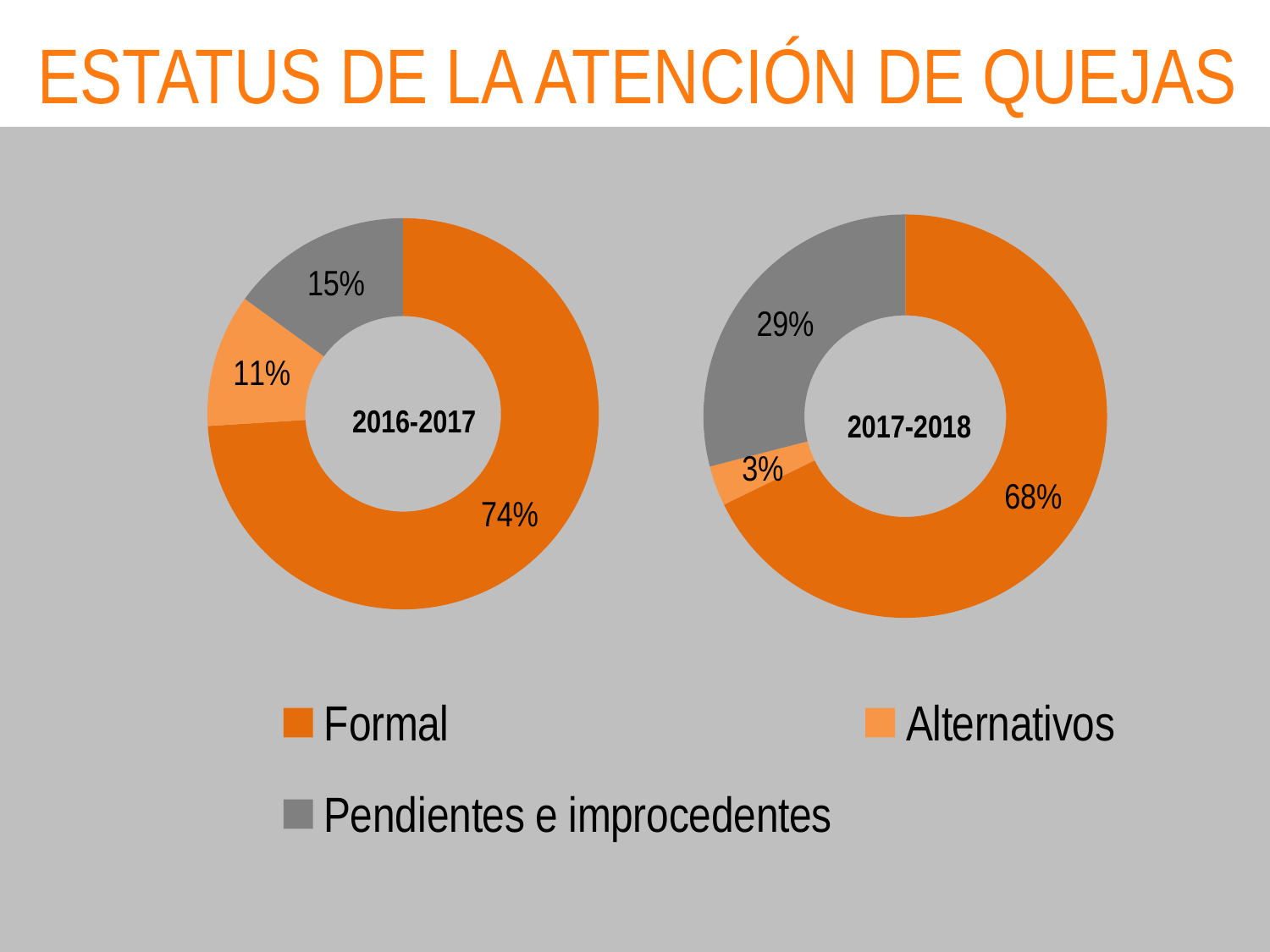
In the 2017-2018 chart, what share is labelled for Pendientes e improcedentes? 29% In the 2017-2018 chart, which category has the smallest share? Alternativos What is the difference between the Formal share in the 2016-2017 chart and the Formal share in the 2017-2018 chart? 6% What kind of chart is used for the 2016-2017 data? Doughnut (pie) chart How many categories does the legend list? 3 In the 2016-2017 chart, which category has the largest share? Formal In the 2017-2018 chart, what share is labelled for Formal? 68% In the 2017-2018 chart, what share is labelled for Alternativos? 3% In the 2016-2017 chart, what share is labelled for Alternativos? 11% In the 2016-2017 chart, what share is labelled for Pendientes e improcedentes? 15% In the 2016-2017 chart, what share is labelled for Formal? 74% Which is larger: the Pendientes e improcedentes share in the 2016-2017 chart or in the 2017-2018 chart? 2017-2018